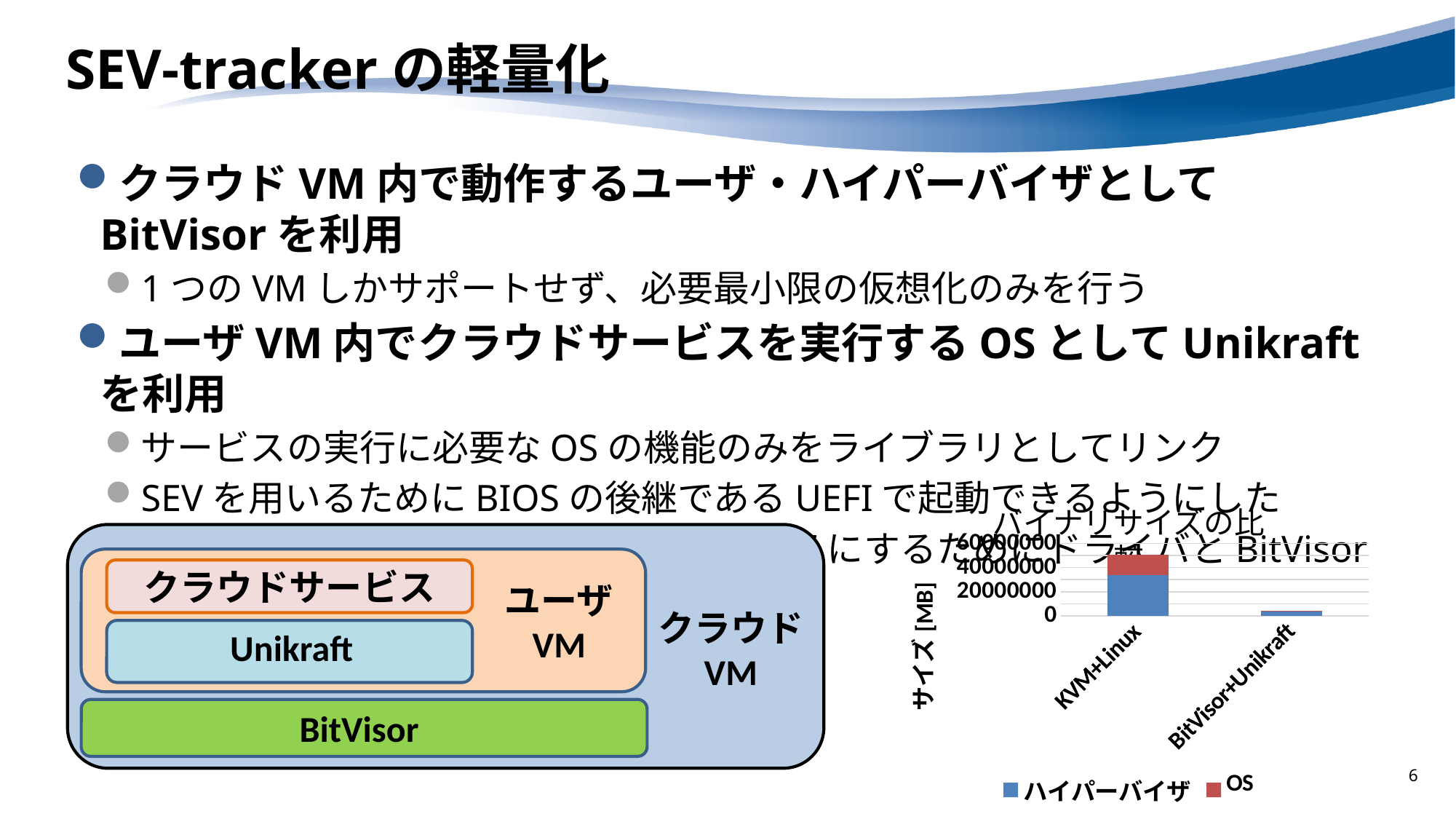
Is the total value for BitVisor+Unikraft greater or less than 20000000? less How many series does the chart's legend list? 2 What kind of chart is shown on the slide? stacked bar chart What is the label of the chart's y axis? サイズ [MB] Which has the larger total bar, KVM+Linux or BitVisor+Unikraft? KVM+Linux What are the two series listed in the chart's legend? ハイパーバイザ and OS Is the total value for KVM+Linux greater or less than 40000000? greater Is the ハイパーバイザ portion of the KVM+Linux bar greater or less than 20000000? greater How many categories are shown on the x axis of the chart? 2 Which category has the tallest bar in the chart? KVM+Linux Which category has the shortest bar in the chart? BitVisor+Unikraft